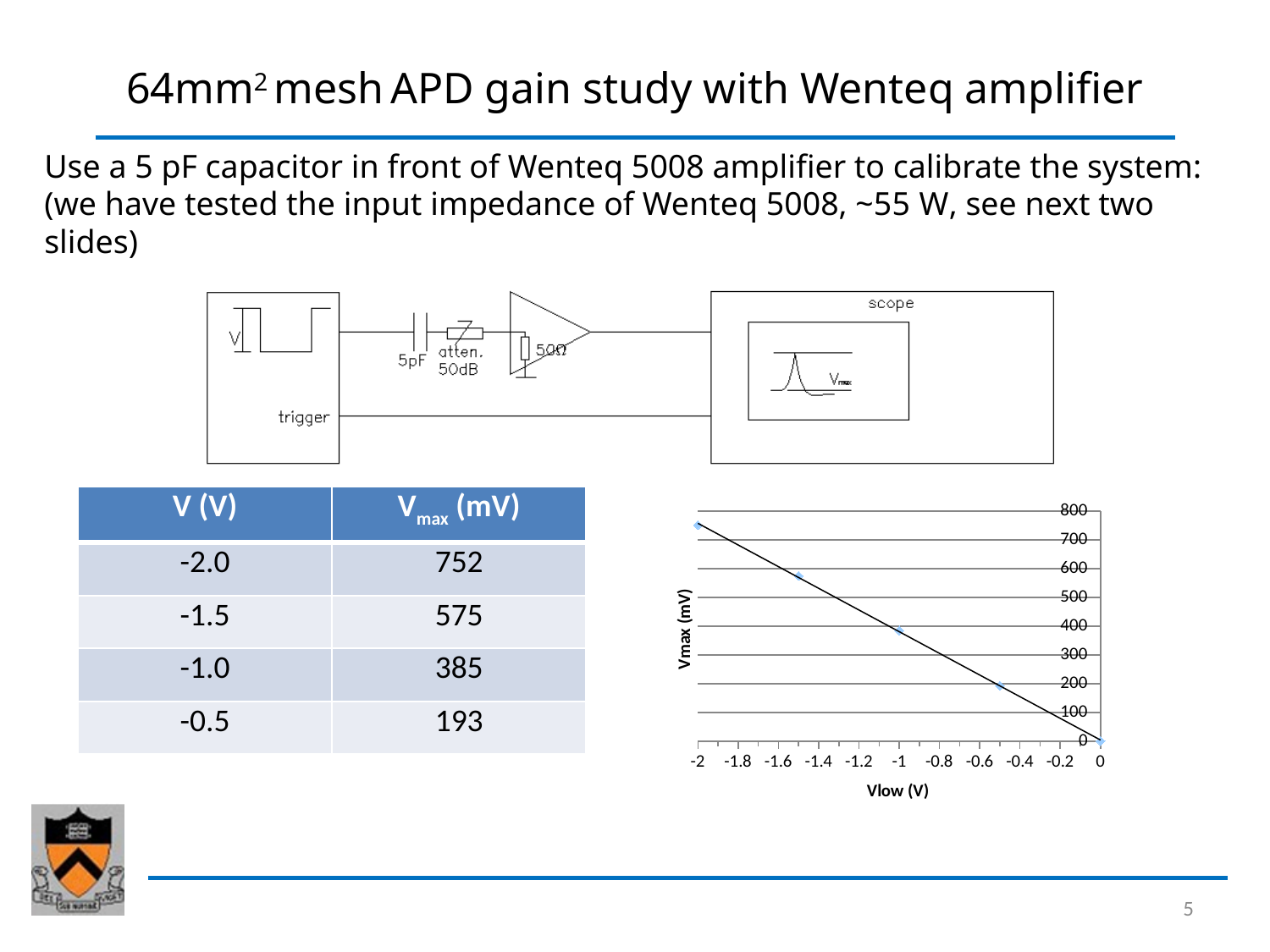
At which Vlow value is the plotted Vmax lowest? 0 Is the value of Vmax at Vlow = -2 greater or less than 700? greater What is the highest tick value shown on the y axis of the chart? 800 What is the label of the y axis of the chart? Vmax (mV) As Vlow increases from -2 to 0 along the x axis, does Vmax rise or fall? fall What kind of chart is shown on the slide? scatter chart with a trend line Is the value of Vmax at Vlow = -1 greater or less than 300? greater Which plotted point has the highest Vmax, the one at Vlow = -2 or the one at Vlow = -0.5? Vlow = -2 Is the value of Vmax at Vlow = -0.5 greater or less than 300? less What is the label of the x axis of the chart? Vlow (V) How many data points are plotted on the chart? 5